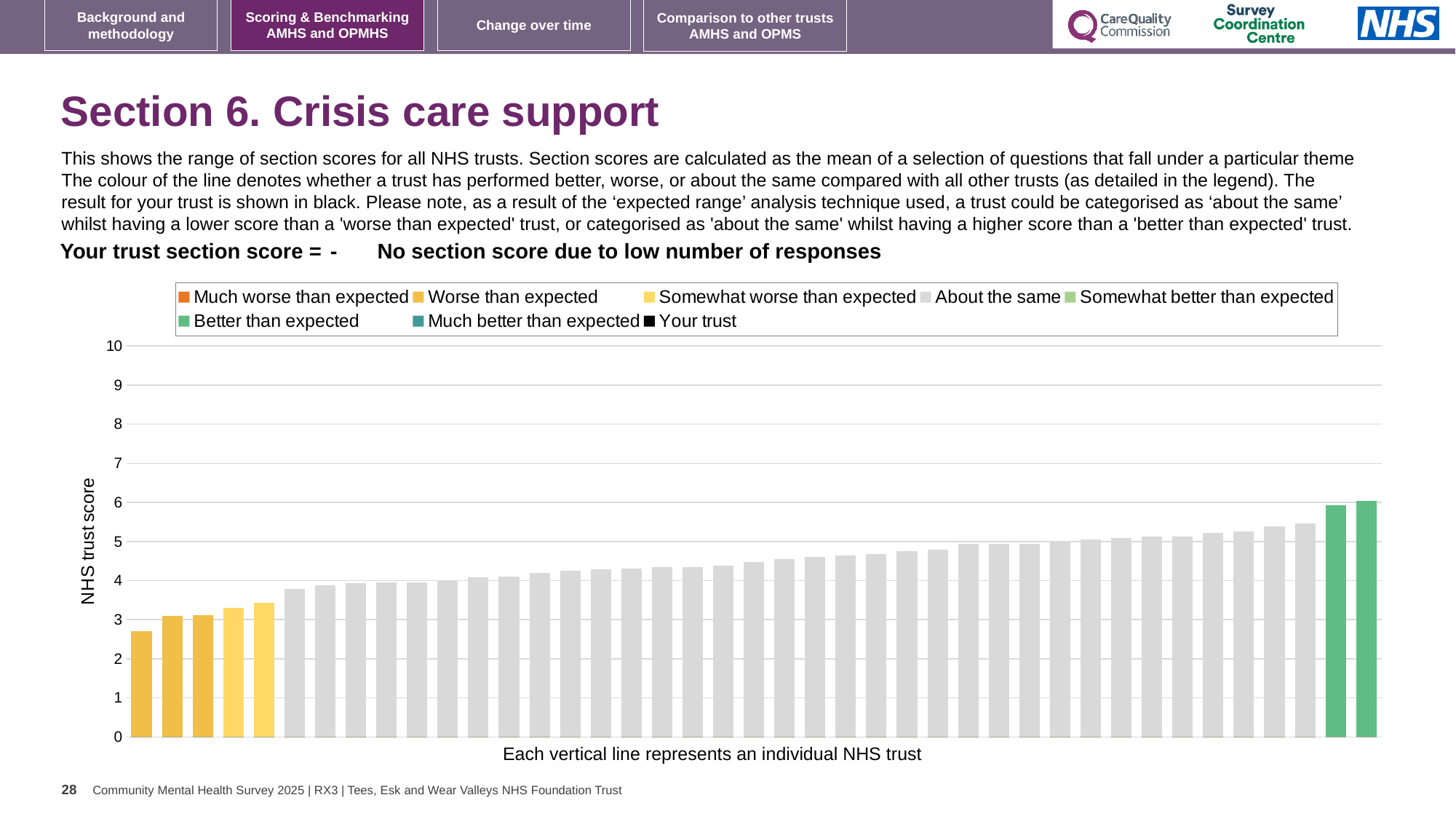
What is the highest value shown on the y axis? 10 What kind of chart is shown on the slide? Bar chart Is the value of the tallest yellow 'Somewhat worse than expected' bar greater or less than 4? less How many bars are coloured green ('Better than expected')? 2 How many bars are coloured in the 'Worse than expected' orange-yellow shade? 3 Is the value of the leftmost (lowest) bar greater or less than 3? less What is the label of the y axis? NHS trust score How many bars are coloured in the 'Somewhat worse than expected' light yellow shade? 2 Do the bar values rise or fall from left to right along the x axis? Rise How many entries does the chart legend list? 8 Is the value of the rightmost (highest) bar greater or less than 5? greater